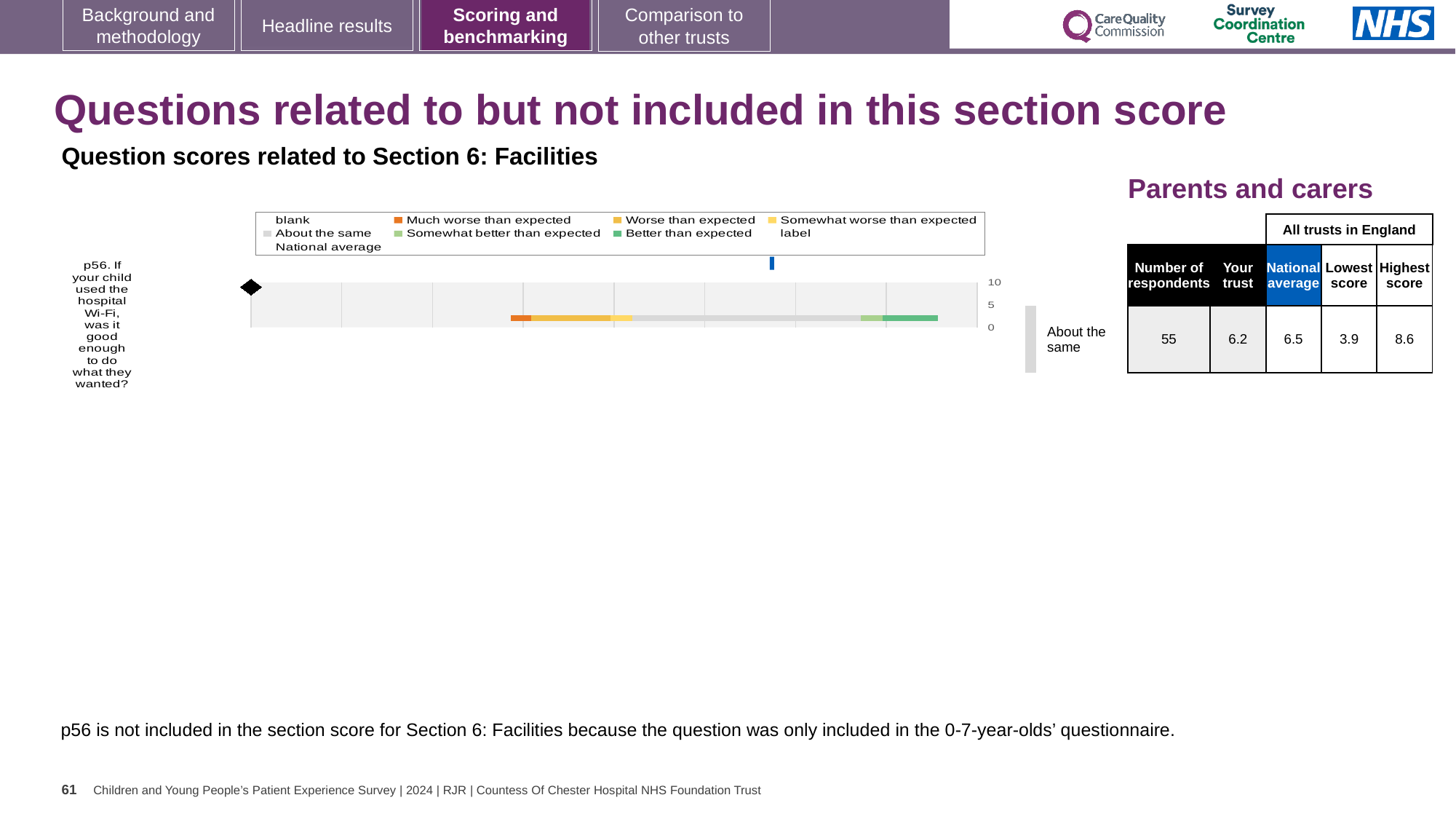
What is the National average score for p56 in the table? 6.5 How many survey questions are plotted in the chart? 1 What benchmark category is the trust's p56 result placed in? About the same How many respondents answered p56? 55 What is the difference between the Highest score and the Lowest score for p56? 4.7 Which question is plotted in the chart? p56. If your child used the hospital Wi-Fi, was it good enough to do what they wanted? What is the Highest score across all trusts in England for p56? 8.6 What is the highest tick value shown on the chart's axis? 10 What kind of chart is shown on the slide? bar chart What is the Lowest score across all trusts in England for p56? 3.9 Which is larger for p56: the 'Your trust' score or the National average? National average What is the 'Your trust' score for p56 in the table? 6.2